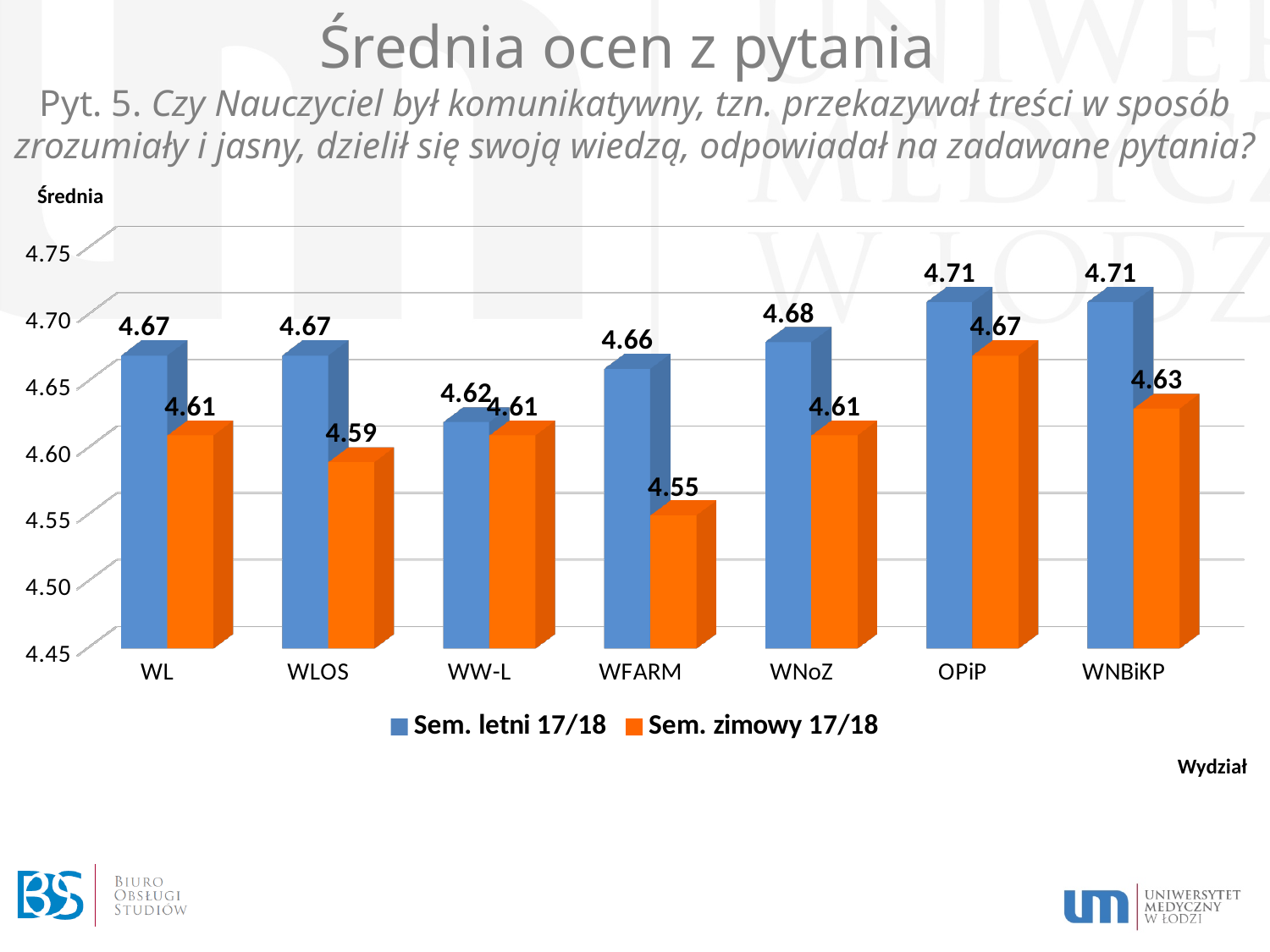
What is the value for WLOS in the Sem. zimowy 17/18 series? 4.59 Which category has the lowest value in the Sem. letni 17/18 series? WW-L How many series does the legend list? 2 What is the value for WFARM in the Sem. zimowy 17/18 series? 4.55 How many categories are shown on the x axis? 7 What is the label of the vertical axis? Średnia Which category has the highest value in the Sem. zimowy 17/18 series? OPiP Which category has the lowest value in the Sem. zimowy 17/18 series? WFARM What is the difference between the Sem. letni 17/18 and Sem. zimowy 17/18 values for WFARM? 0.11 What is the value for OPiP in the Sem. letni 17/18 series? 4.71 Which is larger for WNBiKP: the Sem. letni 17/18 value or the Sem. zimowy 17/18 value? Sem. letni 17/18 What kind of chart is shown on the slide? Bar chart